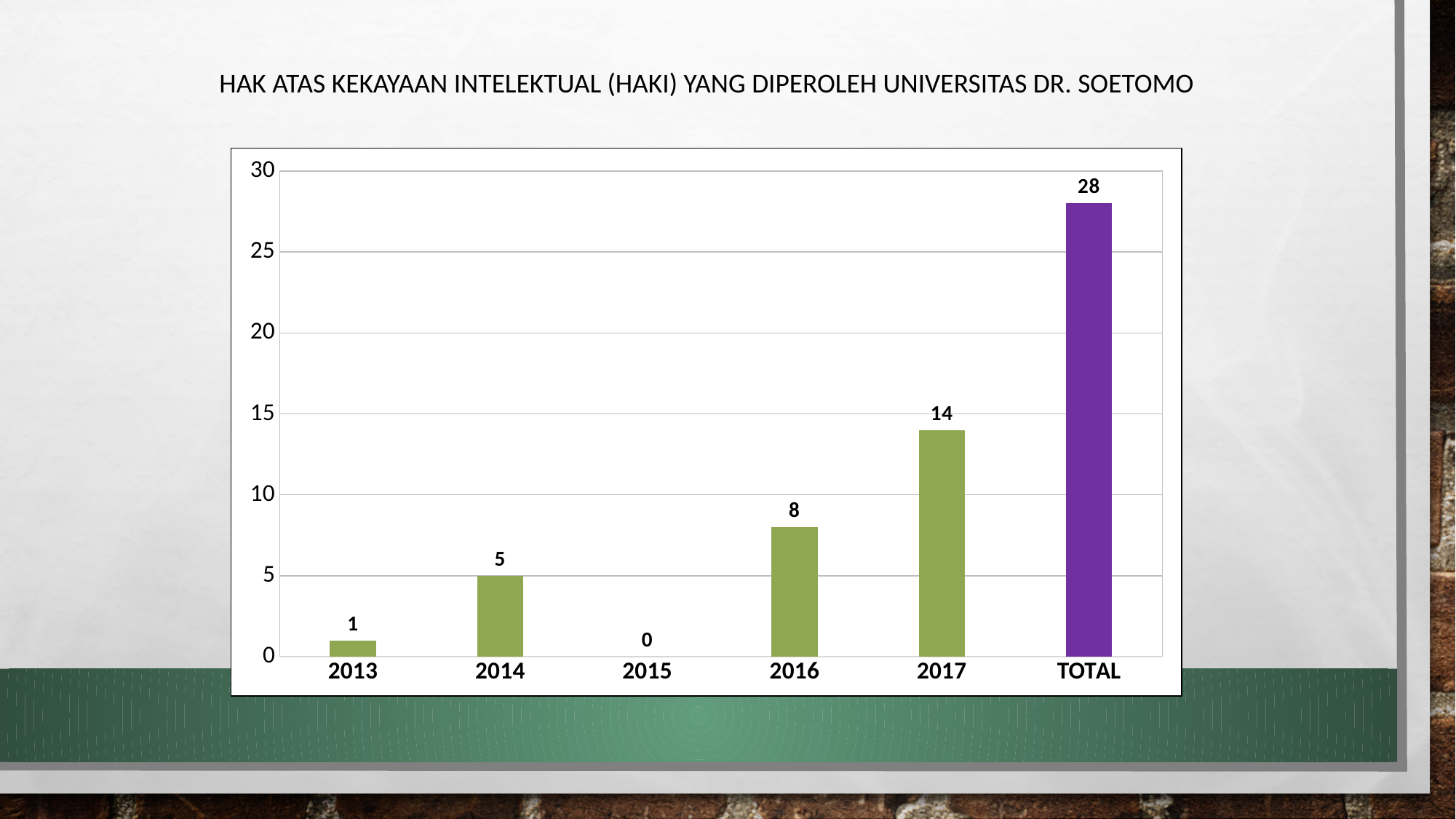
What is the value for 2017? 14 Is the value for TOTAL greater or less than 25? greater Do the values rise or fall from 2015 to 2017? rise What is the value for 2015? 0 Which year from 2013 to 2017 has the highest value? 2017 What is the difference between the values for 2017 and 2016? 6 Which is larger, the value for 2014 or the value for 2016? 2016 What kind of chart is shown on the slide? bar chart How many categories are shown on the x axis? 6 What is the value shown for TOTAL? 28 Which category has the lowest value? 2015 What is the value for 2014? 5